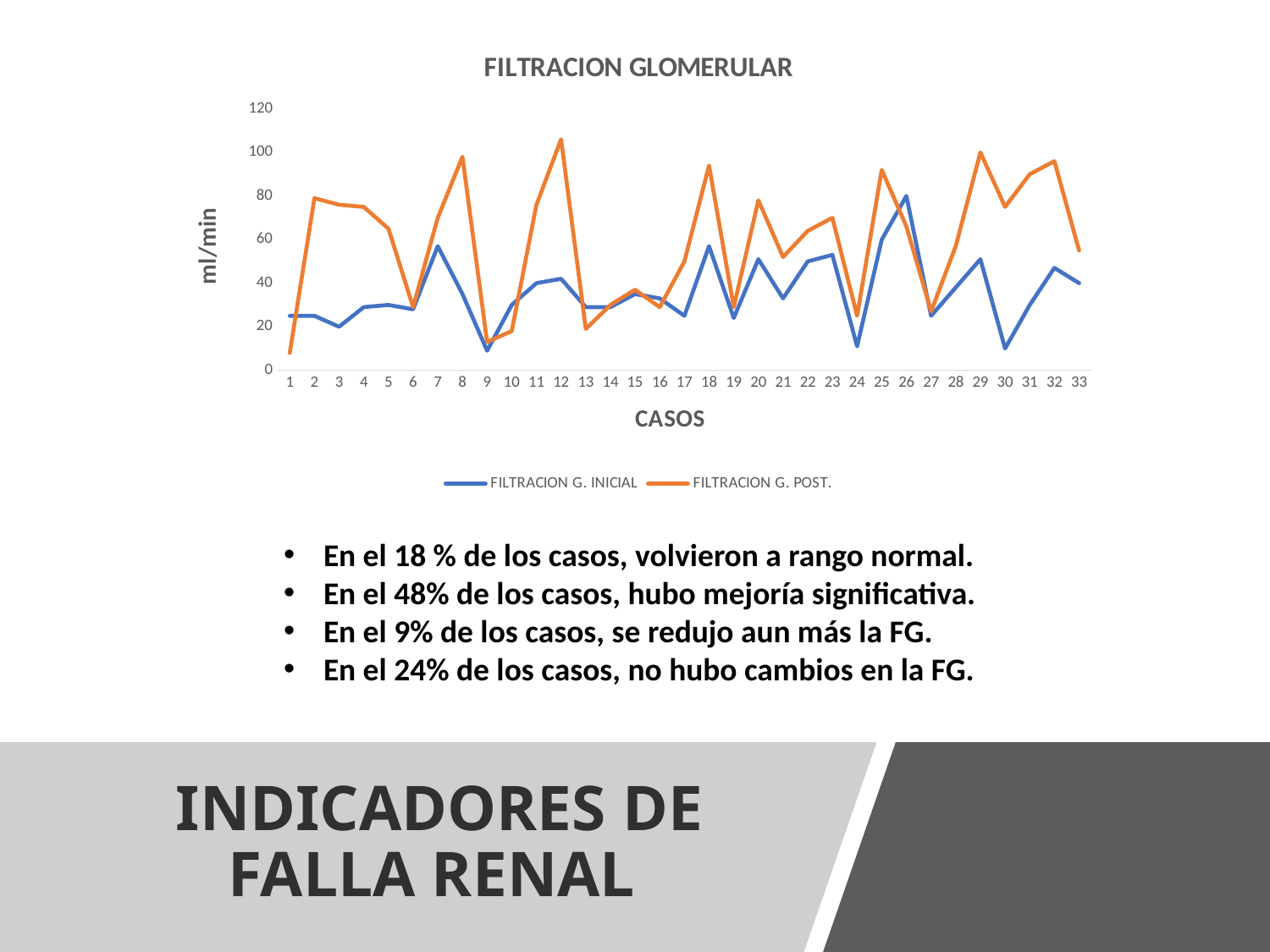
How many cases are plotted along the x axis? 33 For case 26, which series has the larger value, FILTRACION G. INICIAL or FILTRACION G. POST.? FILTRACION G. INICIAL Is the FILTRACION G. INICIAL value for case 24 greater or less than 20? less What is the title of the chart? FILTRACION GLOMERULAR What kind of chart is shown on the slide? line chart Which case has the highest FILTRACION G. INICIAL value? 26 Is the FILTRACION G. POST. value for case 1 greater or less than 20? less Is the FILTRACION G. POST. value for case 12 greater or less than 100? greater What unit is shown on the y axis label? ml/min For case 12, which series has the larger value, FILTRACION G. INICIAL or FILTRACION G. POST.? FILTRACION G. POST. How many series does the legend list? 2